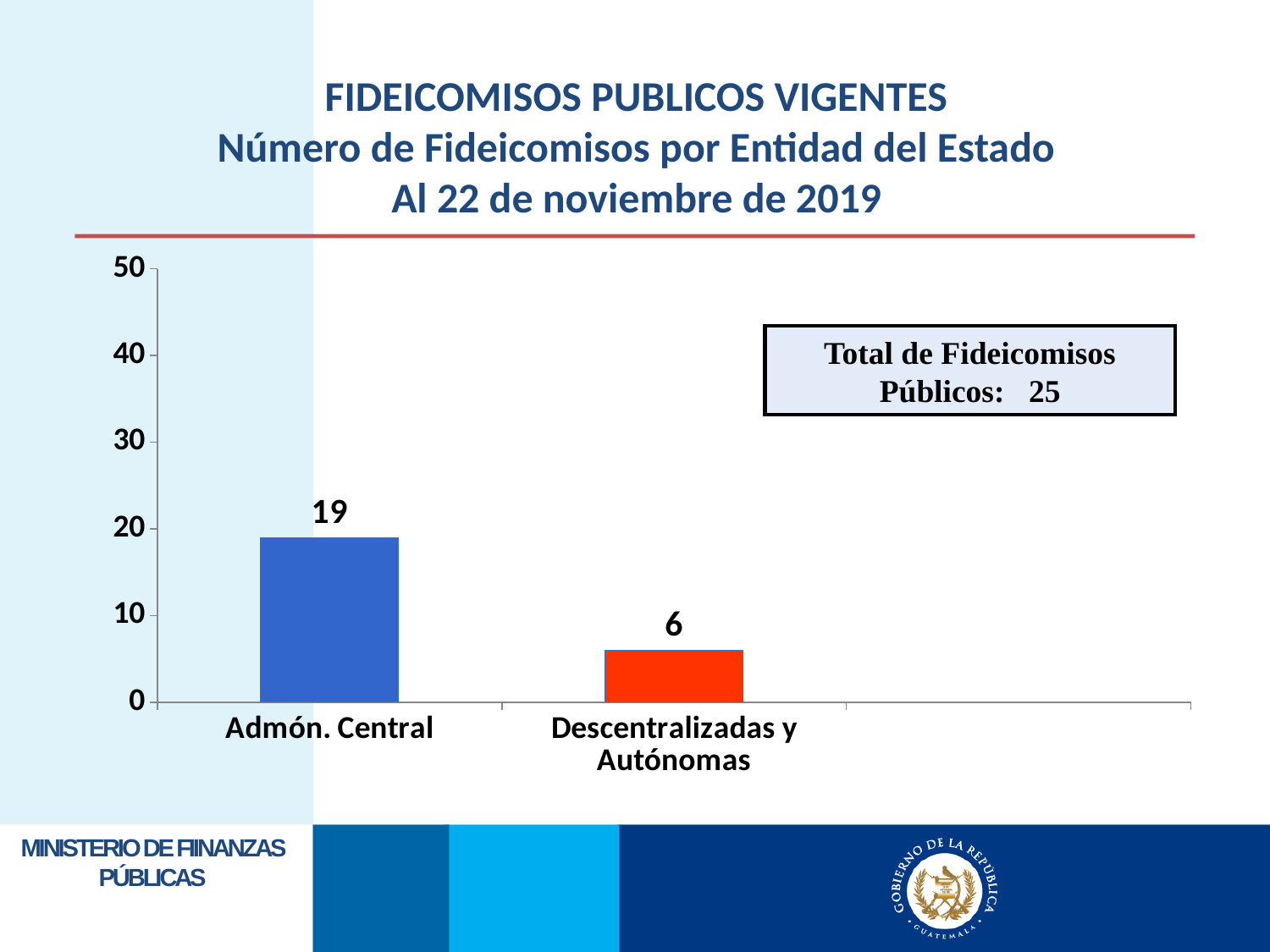
What is the value for Admón. Central? 19 Is the value for Admón. Central greater or less than 20? less Which is larger, the value for Admón. Central or the value for Descentralizadas y Autónomas? Admón. Central What is the highest value shown on the y axis? 50 How many categories are shown on the x axis? 2 Which category has the lowest value? Descentralizadas y Autónomas What kind of chart is shown on the slide? bar chart Which category has the highest value? Admón. Central What is the value for Descentralizadas y Autónomas? 6 Is the value for Descentralizadas y Autónomas greater or less than 10? less What is the difference between the values for Admón. Central and Descentralizadas y Autónomas? 13 What is the total number of public trusts stated in the box on the slide? 25